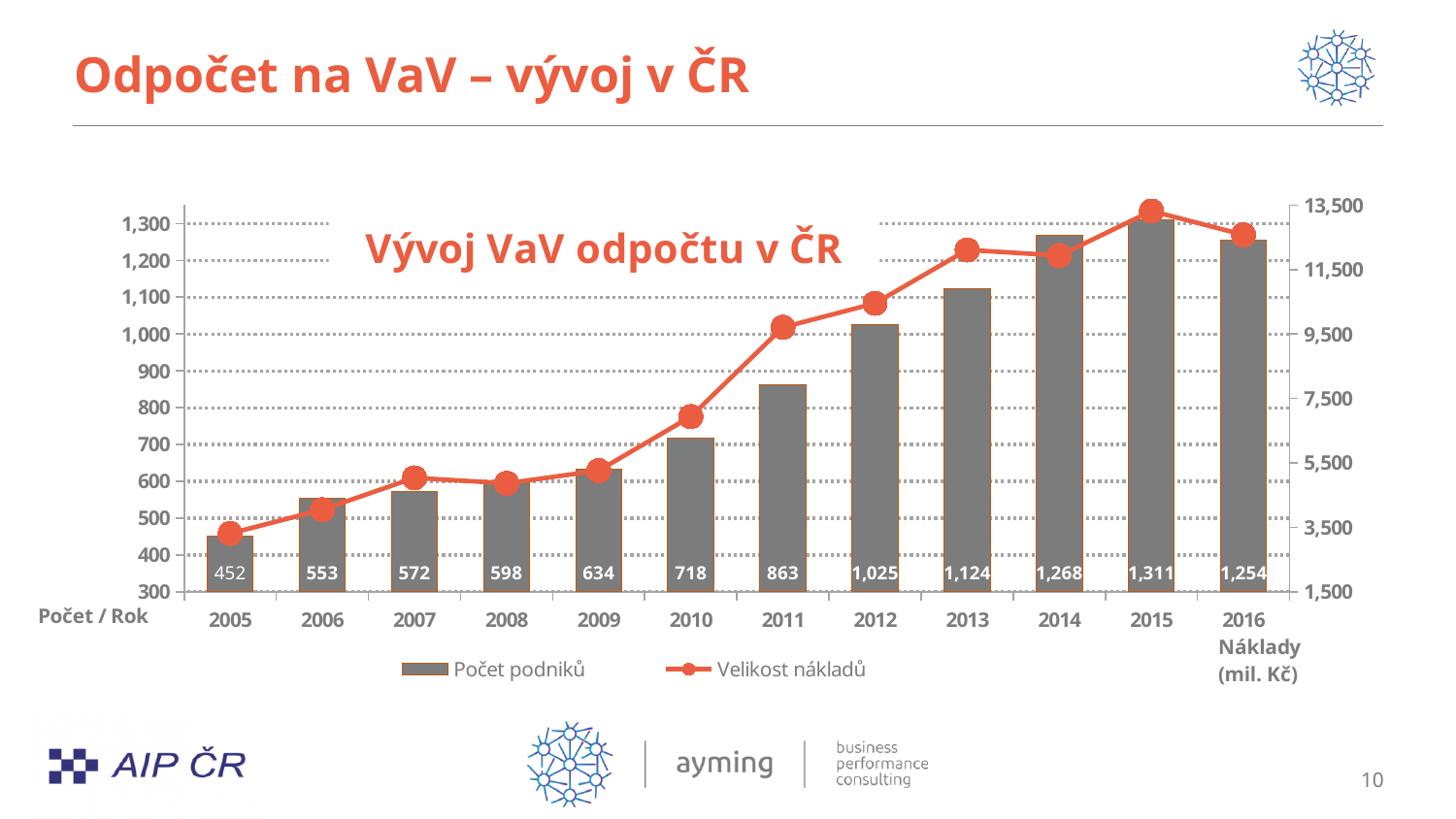
Which year has the highest Počet podniků? 2015 What is the value of Počet podniků for 2009? 634 What is the title of the chart? Vývoj VaV odpočtu v ČR Which year has a larger Počet podniků, 2011 or 2013? 2013 What is the value of Počet podniků for 2012? 1,025 What is the value of Počet podniků for 2005? 452 How many years are shown on the x axis? 12 Is the value of Velikost nákladů for 2007 greater or less than 7,500? less Is the value of Velikost nákladů for 2010 greater or less than 5,500? greater How many series does the legend list? 2 Which year has the lowest Počet podniků? 2005 What is the difference in Počet podniků between 2015 and 2016? 57